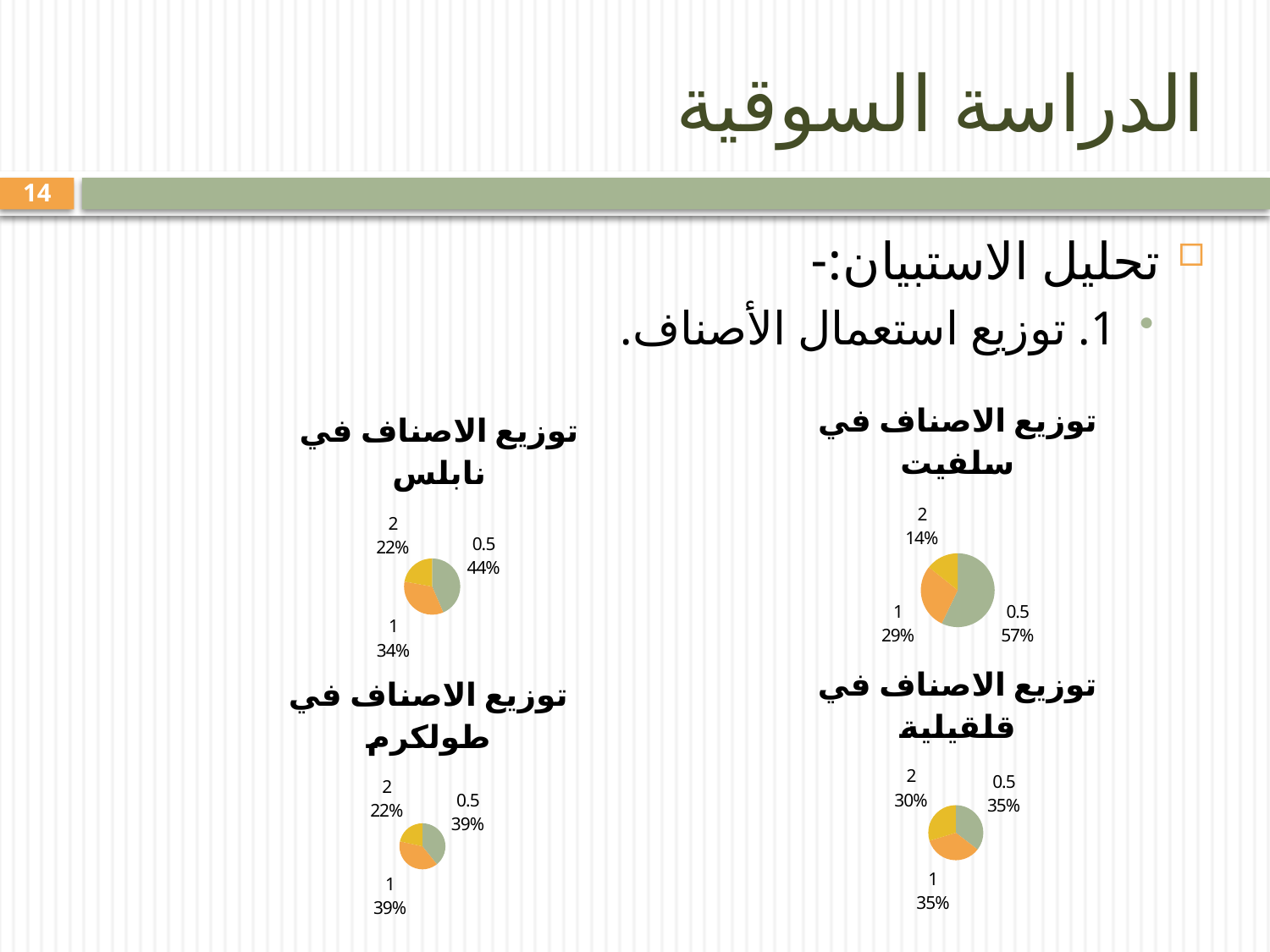
What kind of chart is "توزيع الاصناف في سلفيت"? Pie chart In the chart titled "توزيع الاصناف في نابلس", how many slices does the pie have? 3 In the chart titled "توزيع الاصناف في سلفيت", what is the difference between the shares of category 1 and category 2? 15% In the chart titled "توزيع الاصناف في طولكرم", which category has the smallest slice? 2 In the chart titled "توزيع الاصناف في نابلس", which category has the largest slice? 0.5 In the chart titled "توزيع الاصناف في قلقيلية", what is the difference between the shares of category 0.5 and category 2? 5% In the chart titled "توزيع الاصناف في قلقيلية", what share does category 2 have? 30% In the chart titled "توزيع الاصناف في طولكرم", what share does category 0.5 have? 39% In the chart titled "توزيع الاصناف في سلفيت", which category has the smallest slice? 2 How many pie charts are shown on the slide? 4 In the chart titled "توزيع الاصناف في نابلس", what share does category 1 have? 34% In the chart titled "توزيع الاصناف في سلفيت", what share does the 0.5 slice have? 57%